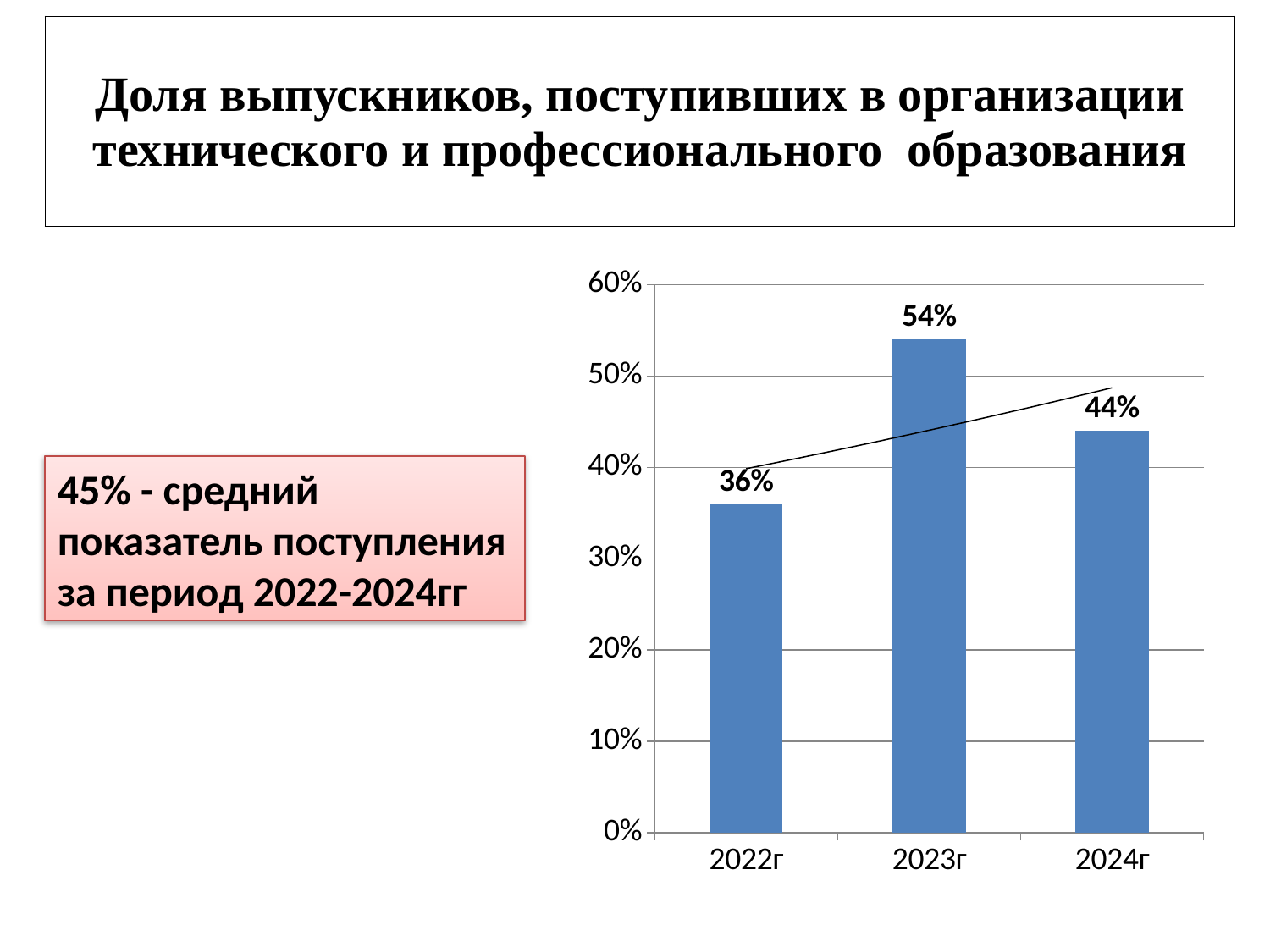
Which is larger, the value for 2024г or the value for 2022г? 2024г Which year has the highest value? 2023г What is the value for 2024г? 44% How many years are shown on the x axis? 3 What kind of chart is shown on the slide? bar chart What is the difference between the values for 2023г and 2024г? 10% Is the value for 2023г greater or less than 50%? greater What average admission rate for 2022-2024 is stated in the text box on the slide? 45% What is the value for 2022г? 36% Which year has the lowest value? 2022г What is the difference between the values for 2023г and 2022г? 18% What is the value for 2023г? 54%